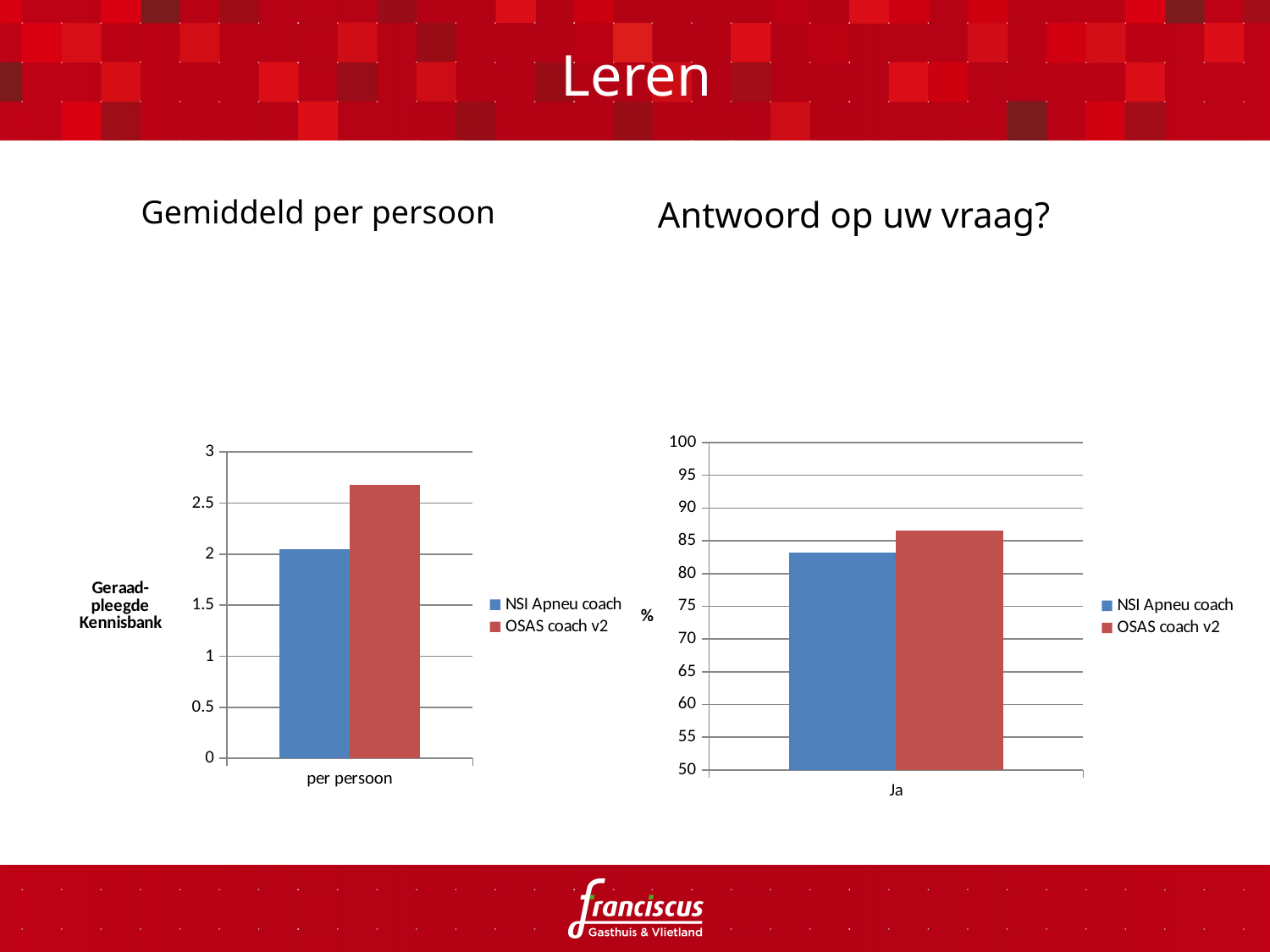
In the left chart (Gemiddeld per persoon), what is the category label on the x axis? per persoon In the left chart (Gemiddeld per persoon), how many series does the legend list? 2 In the right chart (Antwoord op uw vraag?), is the value for NSI Apneu coach greater or less than 80? greater In the left chart (Gemiddeld per persoon), what kind of chart is shown? bar chart In the right chart (Antwoord op uw vraag?), is the value for OSAS coach v2 greater or less than 90? less In the left chart (Gemiddeld per persoon), what is the label on the vertical axis? Geraadpleegde Kennisbank In the right chart (Antwoord op uw vraag?), what is the lowest value shown on the vertical axis? 50 In the left chart (Gemiddeld per persoon), is the value for OSAS coach v2 greater or less than 2.5? greater In the right chart (Antwoord op uw vraag?), how many categories are shown on the x axis? 1 In the right chart (Antwoord op uw vraag?), which series has the higher value for Ja, NSI Apneu coach or OSAS coach v2? OSAS coach v2 In the left chart (Gemiddeld per persoon), which series has the taller bar, NSI Apneu coach or OSAS coach v2? OSAS coach v2